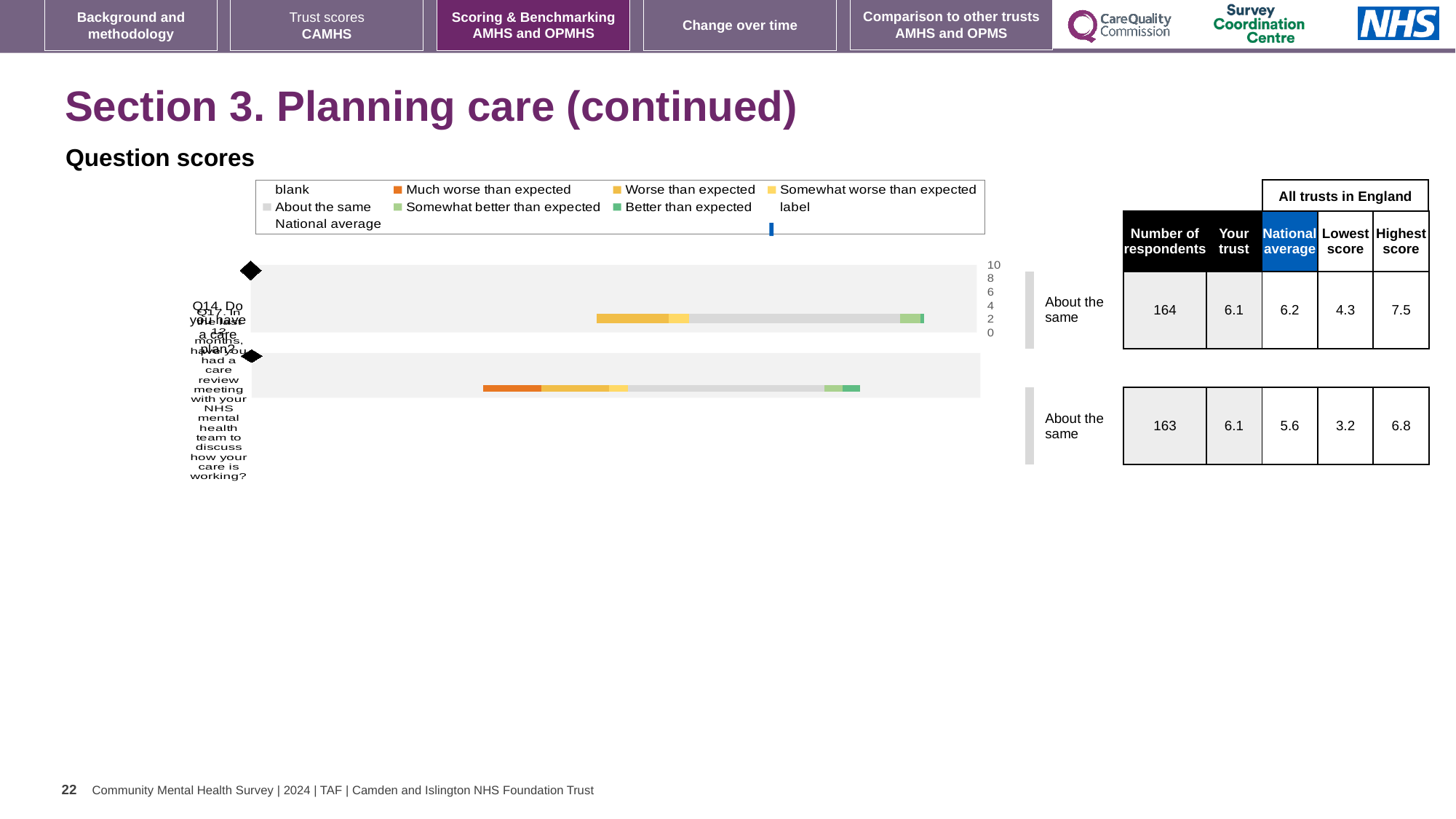
In the table beside the chart, what is the national average for Q14? 6.2 In the table beside the chart, what is the 'Your trust' score for Q17? 6.1 In the table beside the chart, what is the difference between the highest and lowest scores for Q17? 3.6 Which legend entry is shown in orange? Much worse than expected In the table beside the chart, what is the lowest score across all trusts in England for Q14? 4.3 In the table beside the chart, what is the highest score across all trusts in England for Q17? 6.8 How many questions (bars) are plotted in the chart? 2 What kind of chart is shown on the slide? bar chart In the table beside the chart, what is the number of respondents for Q14? 164 What benchmark category is shown next to the Q14 bar? About the same In the table beside the chart, which is larger for Q17: the 'Your trust' score or the national average? Your trust How many entries does the chart legend list? 9